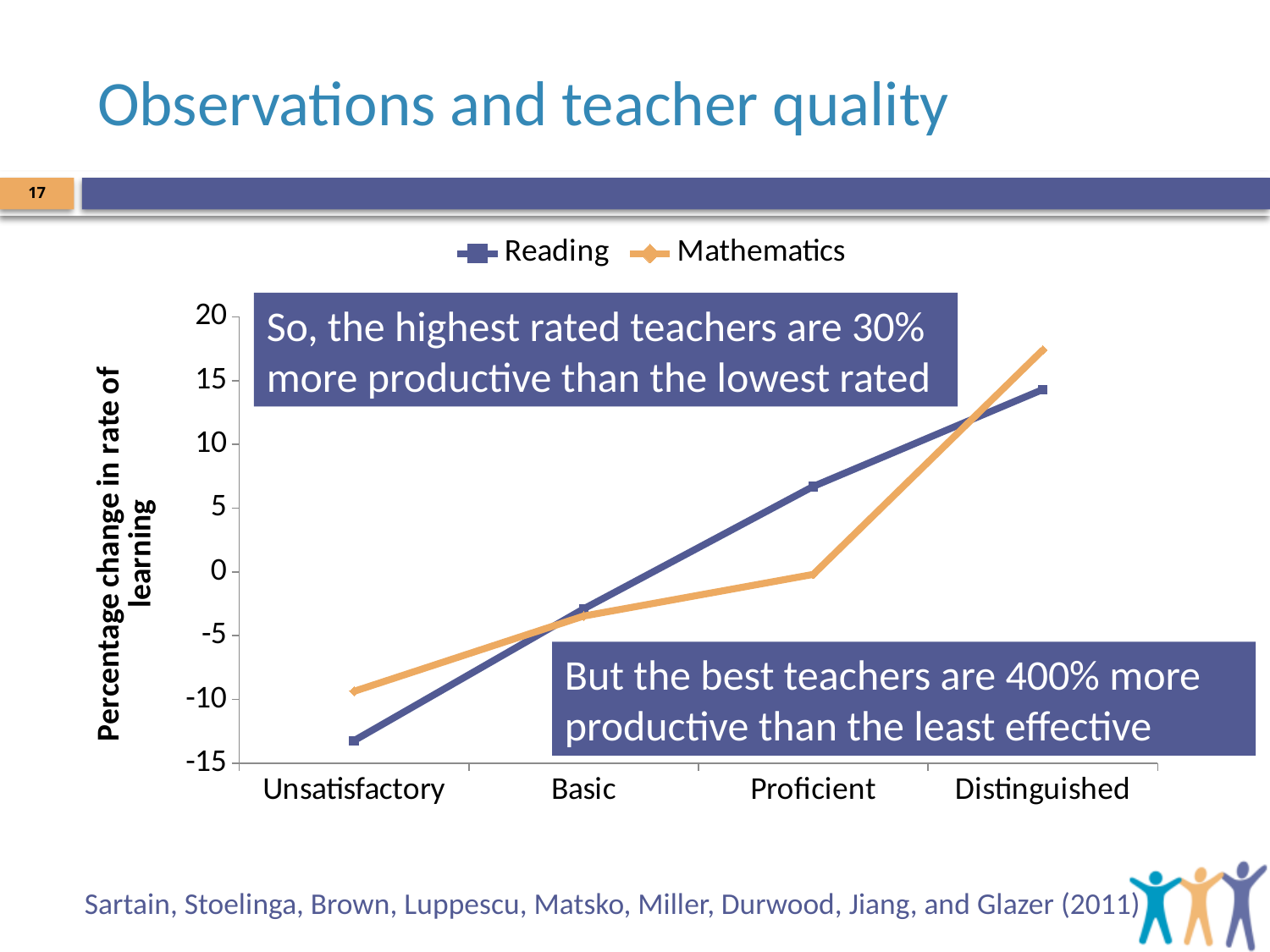
Is the Mathematics value for Distinguished greater or less than 15? greater At Proficient, which series has the larger value, Reading or Mathematics? Reading What kind of chart is shown on the slide? Line chart Do the Reading values rise or fall from Unsatisfactory to Distinguished? Rise How many categories are shown on the x axis? 4 For which category is the Reading value highest? Distinguished How many series does the legend list? 2 Is the Reading value for Proficient greater or less than 5? greater For which category is the Mathematics value lowest? Unsatisfactory Which series are listed in the legend? Reading and Mathematics Is the Reading value for Unsatisfactory greater or less than -10? less What is the title of the vertical axis? Percentage change in rate of learning